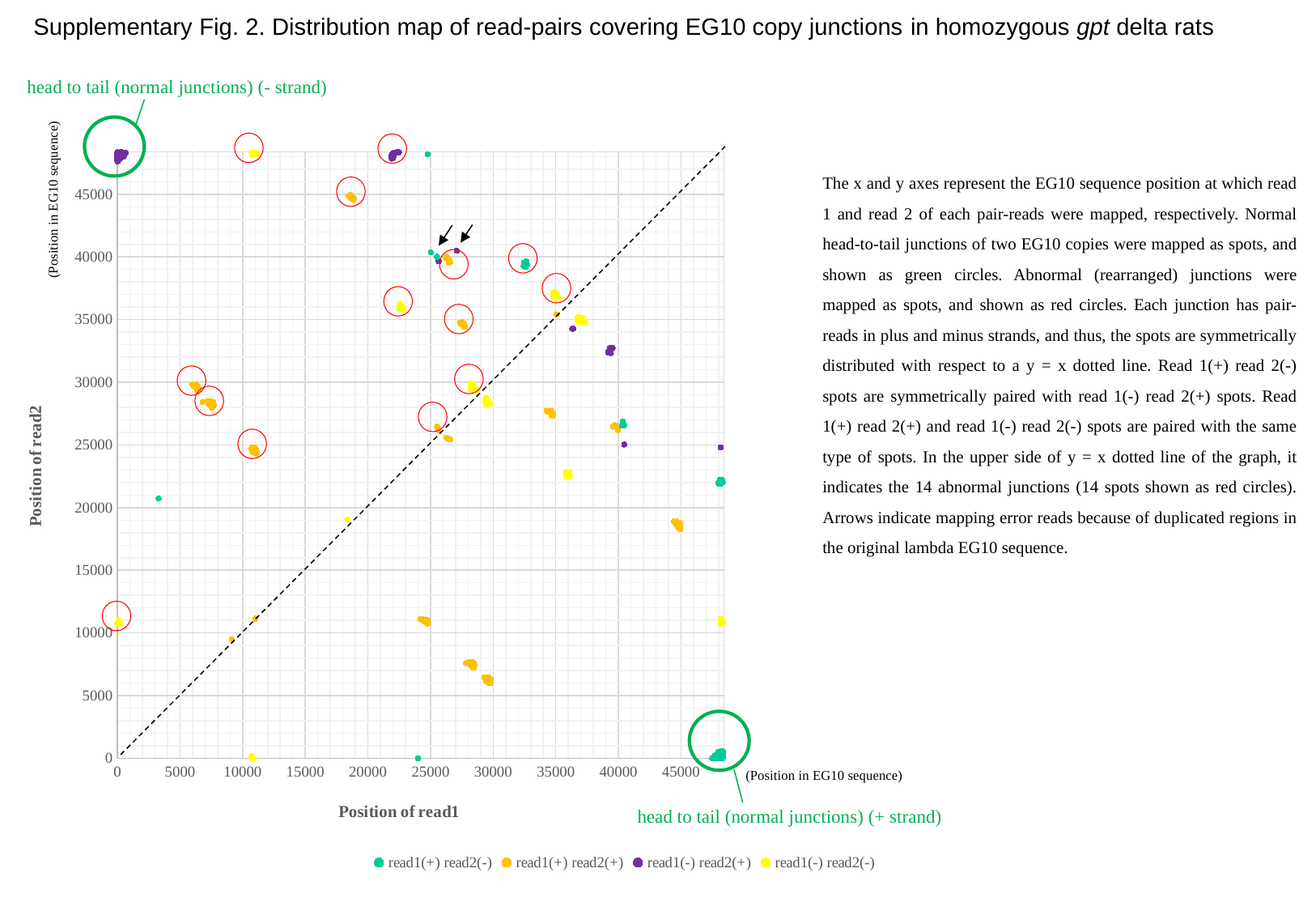
Is the Position of read1 value of the spot inside the green circle at the bottom right of the chart greater or less than 45000? greater Which legend entry is shown with a yellow marker? read1(-) read2(-) Is the Position of read2 value of the red-circled spot at Position of read1 = 0 greater or less than 15000? less Is the Position of read2 value of the spot inside the green circle at the bottom right of the chart greater or less than 5000? less How many red circles (abnormal junctions) are drawn on the chart? 14 What kind of chart is shown on the slide? scatter plot How many green circles (normal head-to-tail junctions) are drawn on the chart? 2 What is the label of the x axis of the chart? Position of read1 How many series does the chart legend list? 4